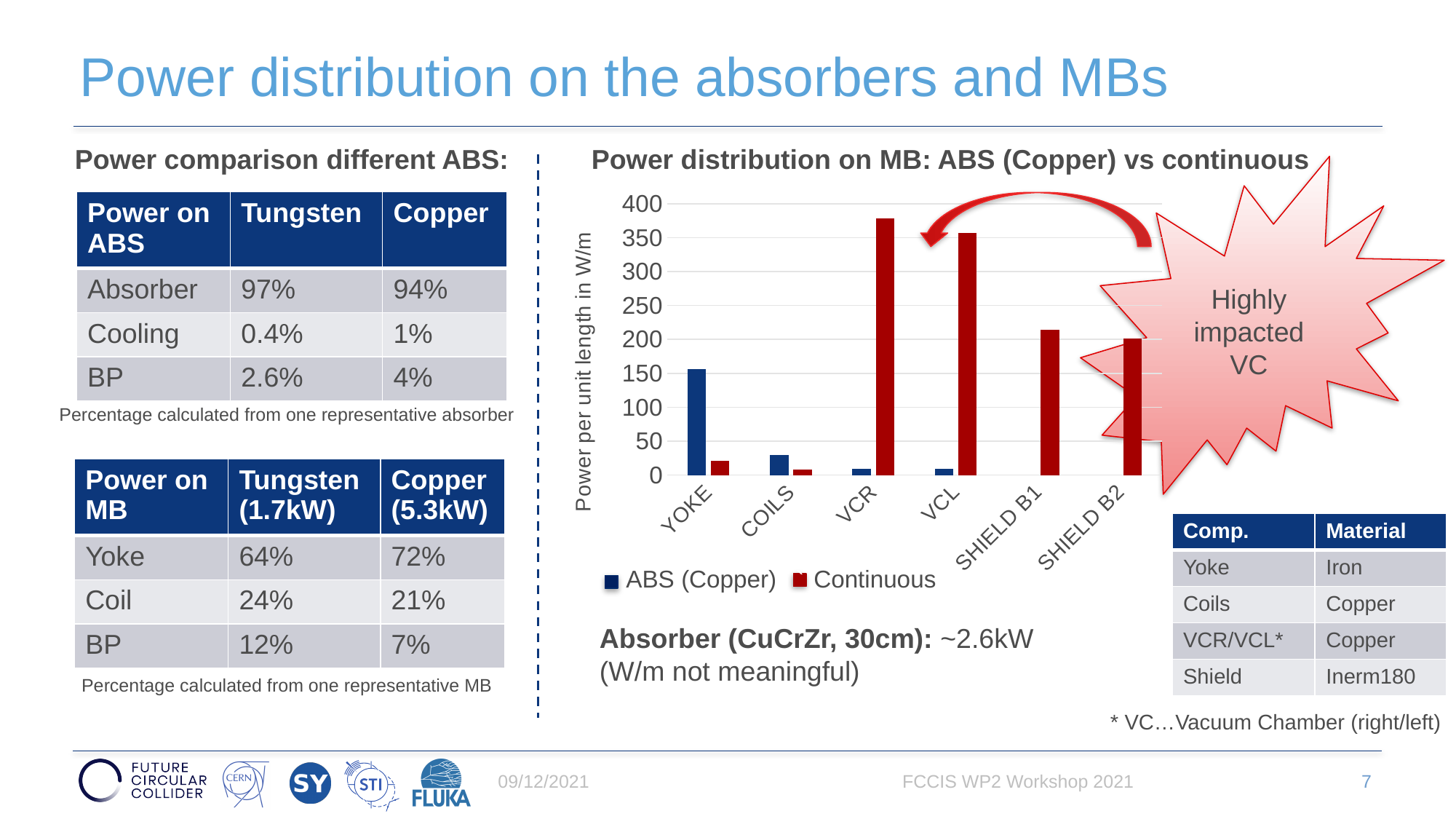
Is the Continuous value for VCR greater or less than 350? greater For YOKE, which series has the larger value, ABS (Copper) or Continuous? ABS (Copper) Is the Continuous value for SHIELD B1 greater or less than 250? less Is the Continuous value for YOKE greater or less than 50? less What is the label of the y axis of the chart? Power per unit length in W/m How many categories are shown on the x axis of the chart? 6 How many series does the chart legend list? 2 Which category has the highest ABS (Copper) value in the chart? YOKE What kind of chart is shown on the slide? bar chart Which category has the highest Continuous value in the chart? VCR For VCL, which series has the larger value, ABS (Copper) or Continuous? Continuous